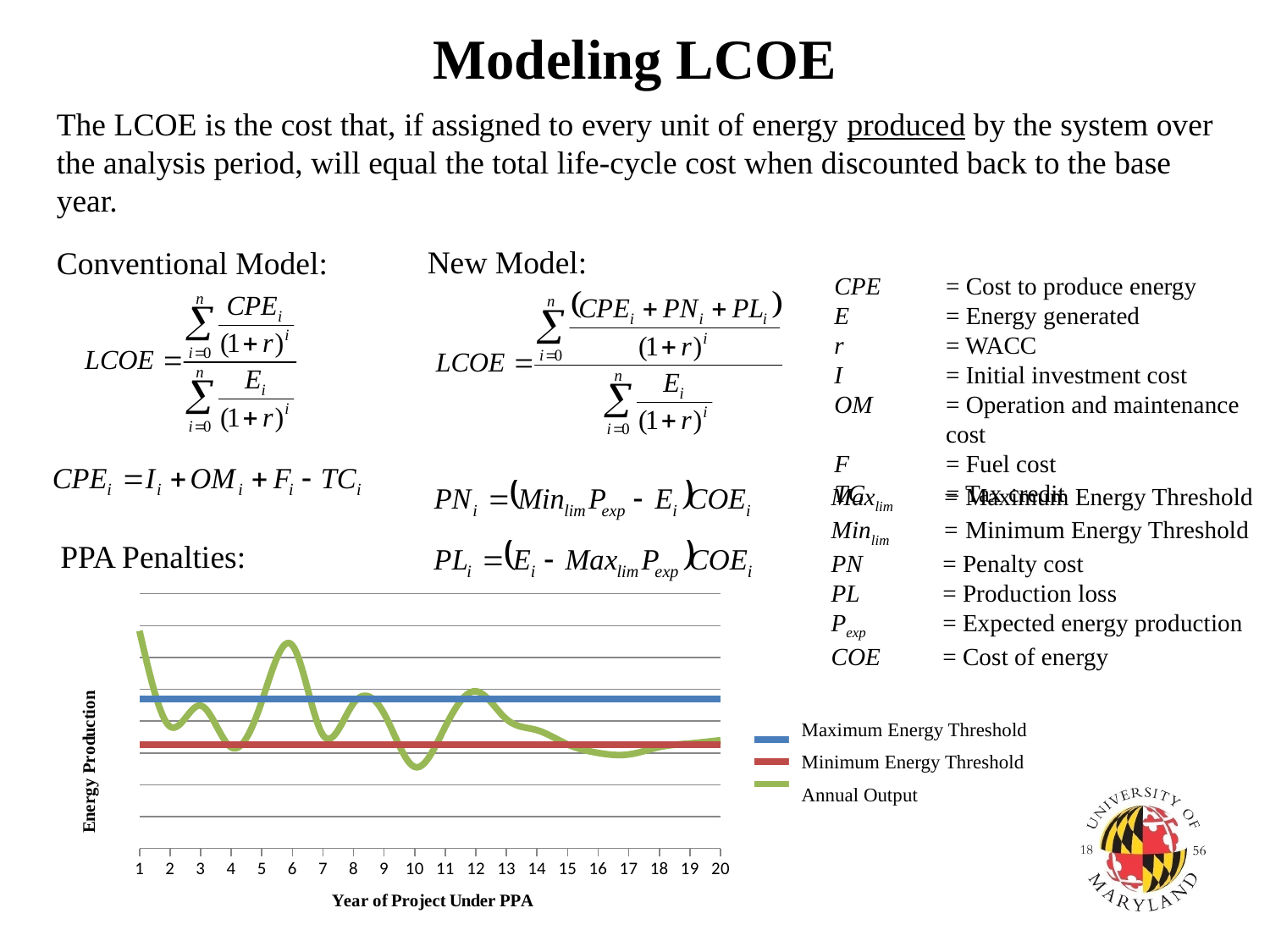
In the energy production chart, does the Annual Output overall rise or fall from year 1 to year 20? fall In the energy production chart, which of the two threshold lines is higher, Maximum Energy Threshold or Minimum Energy Threshold? Maximum Energy Threshold In the energy production chart, is the Annual Output in year 10 above or below the Minimum Energy Threshold? below What is the title of the x axis of the energy production chart? Year of Project Under PPA In the energy production chart, is the Annual Output in year 6 higher or lower than in year 10? higher How many series does the legend of the energy production chart list? 3 How many years are plotted along the x axis of the energy production chart? 20 In the energy production chart, in which year is the Annual Output lowest? 10 In the energy production chart, in which year is the Annual Output highest? 1 What kind of chart is shown at the bottom left of the slide? Line chart Which series in the energy production chart is drawn in green? Annual Output